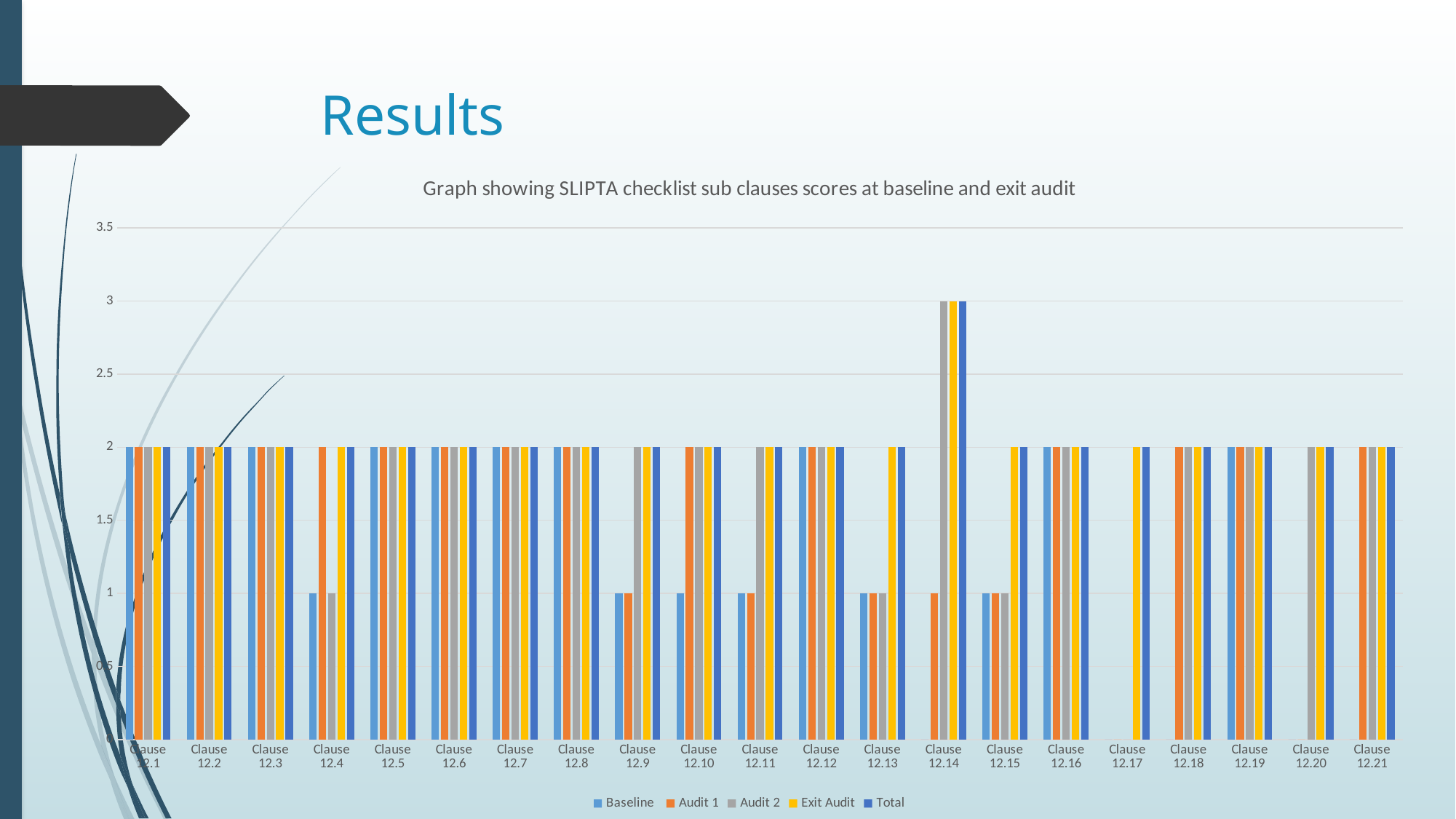
What is the title of the chart? Graph showing SLIPTA checklist sub clauses scores at baseline and exit audit Which clause has the highest Total score? Clause 12.14 What is the Baseline score for Clause 12.4? 1 What is the Exit Audit score for Clause 12.9? 2 Which is larger for Clause 12.11: the Audit 1 score or the Audit 2 score? Audit 2 Is the Audit 2 value for Clause 12.14 greater or less than 2.5? greater What kind of chart is shown on the slide? Bar chart How many series does the legend list? 5 What is the difference between the Exit Audit score and the Baseline score for Clause 12.13? 1 How many clauses (categories) are shown on the x axis? 21 What is the Audit 1 score for Clause 12.14? 1 What is the Total score for Clause 12.14? 3